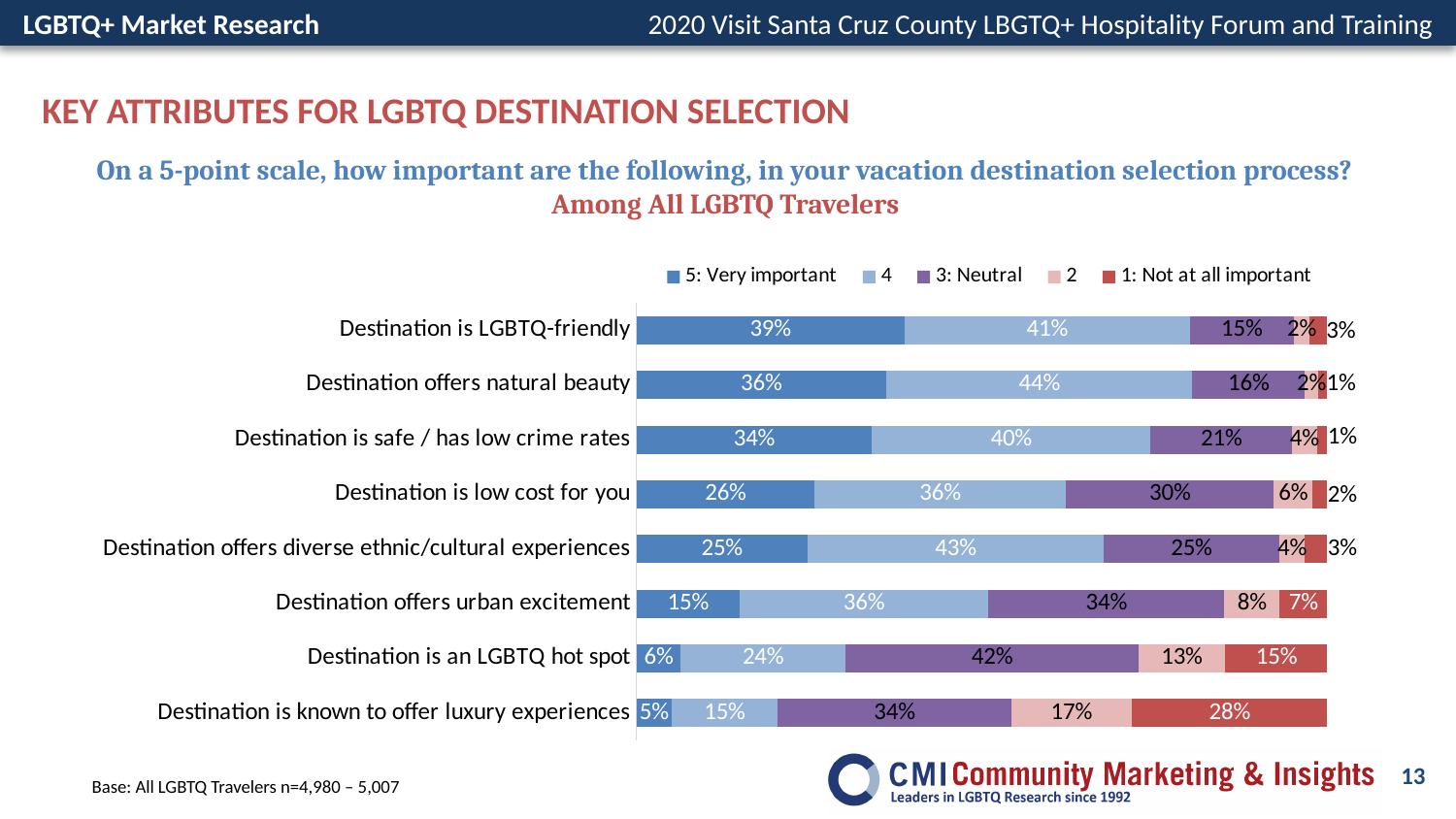
What is the first legend entry in the chart? 5: Very important What percentage rated "Destination is known to offer luxury experiences" as 1: Not at all important? 28% Which attribute has the lowest share of 5: Very important ratings? Destination is known to offer luxury experiences What type of chart is shown on the slide? Stacked bar chart Which attribute has the highest share of 5: Very important ratings? Destination is LGBTQ-friendly How many series does the legend list? 5 What percentage rated "Destination is an LGBTQ hot spot" as 3: Neutral? 42% What percentage of LGBTQ travelers rated "Destination is LGBTQ-friendly" as 5: Very important? 39% How many destination attributes are shown in the chart? 8 What is the combined percentage of 5: Very important and 4 ratings for "Destination offers urban excitement"? 51% Which has a larger 4 rating share: "Destination offers natural beauty" or "Destination is safe / has low crime rates"? Destination offers natural beauty What is the difference between the 5: Very important percentages for "Destination offers natural beauty" and "Destination is low cost for you"? 10%